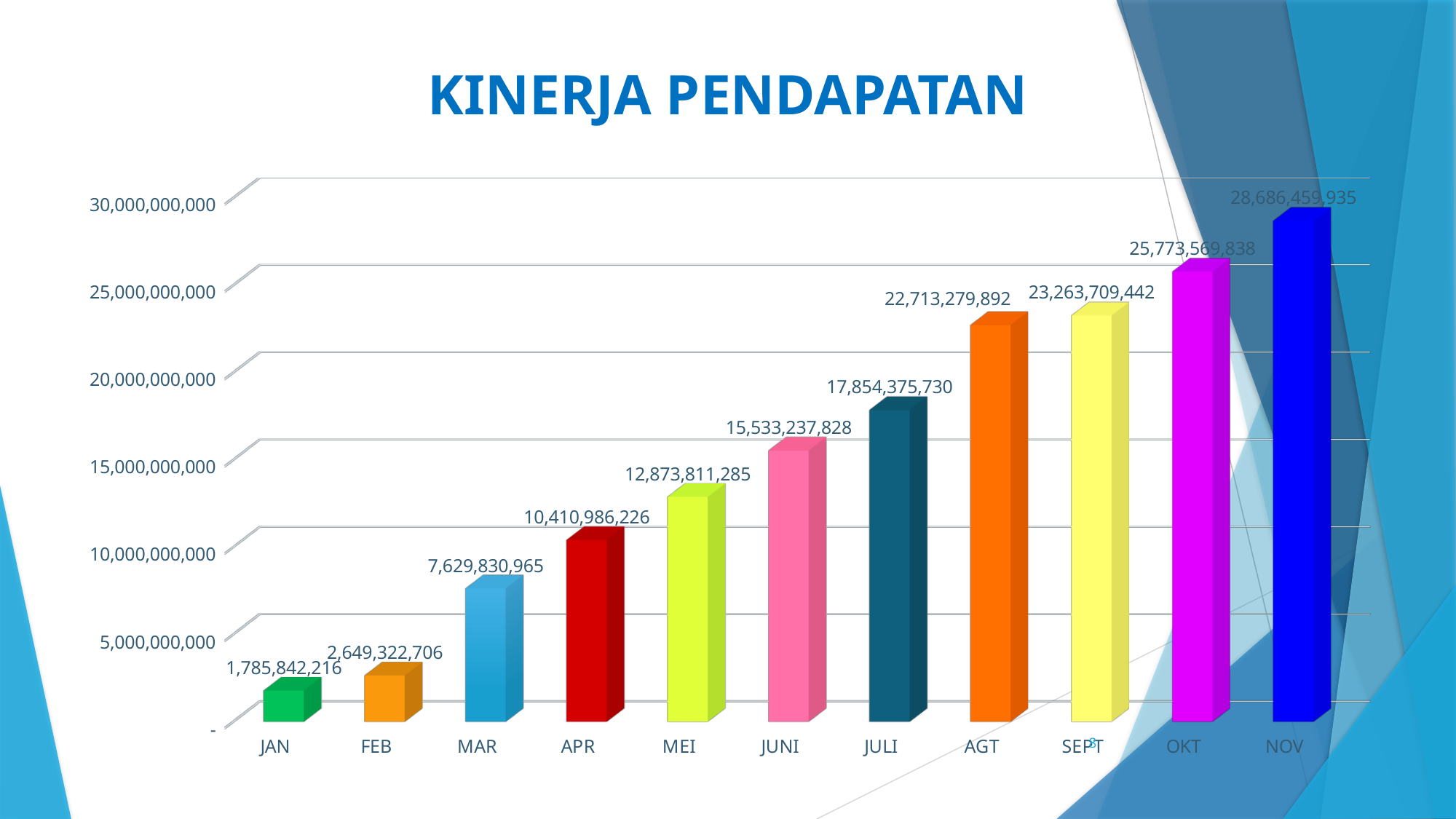
Which month has the lowest value? JAN What is the value for MAR? 7,629,830,965 How many months are shown on the x axis? 11 Is the value for AGT greater or less than 20,000,000,000? greater What is the value for OKT? 25,773,569,838 Which is larger, the value for APR or the value for MEI? MEI What is the value for JULI? 17,854,375,730 What is the difference between the values for NOV and OKT? 2,912,890,097 What kind of chart is shown on the slide? Bar chart Which month has the highest value? NOV What is the difference between the values for FEB and JAN? 863,480,490 Do the values rise or fall from JAN to NOV? Rise